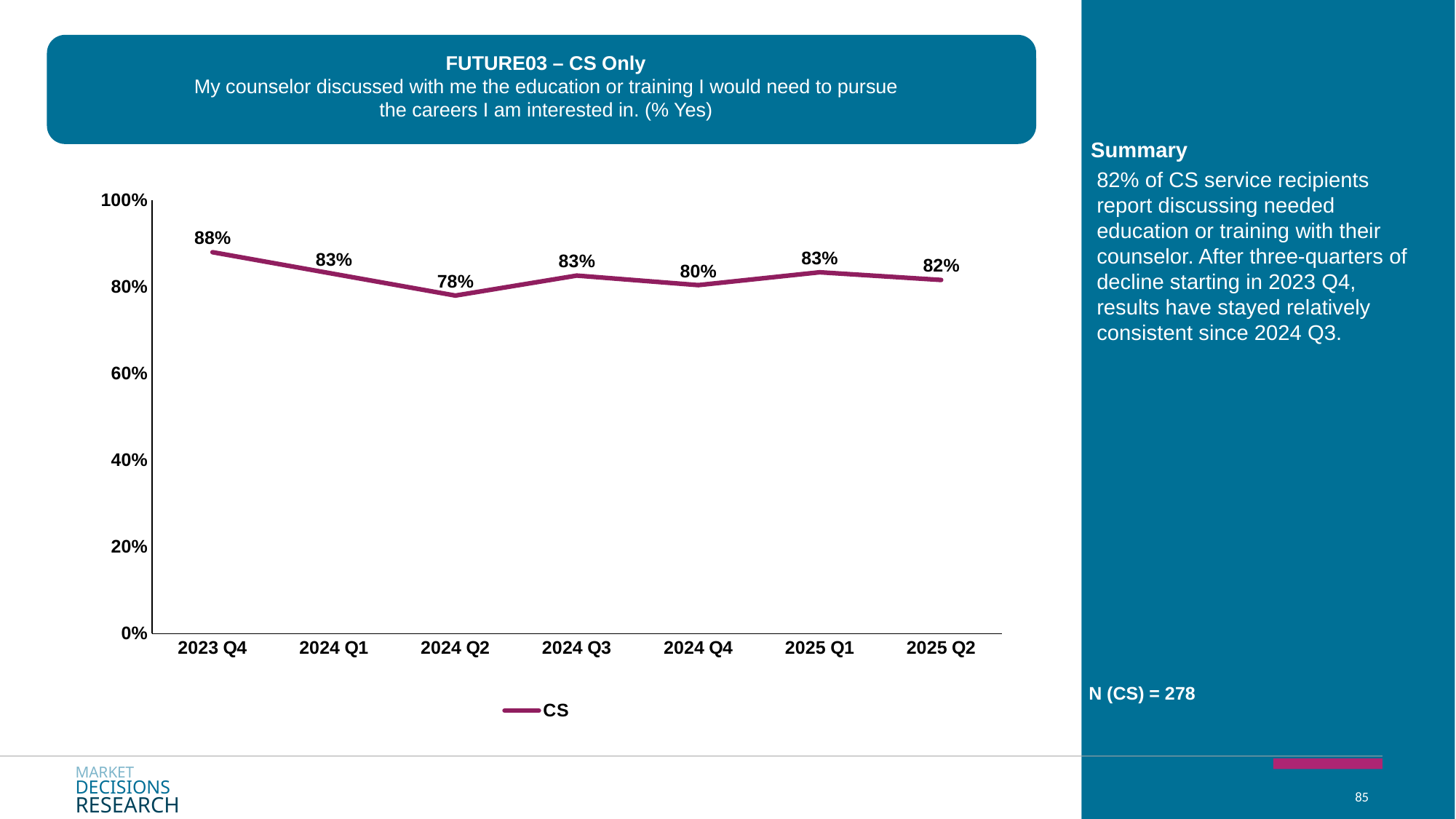
What is the value for 2024 Q2? 78% What is the value for 2023 Q4? 88% What is the value for 2024 Q4? 80% Which is larger, the value for 2024 Q4 or the value for 2025 Q1? 2025 Q1 What is the difference between the values for 2023 Q4 and 2024 Q2? 10% Which quarter has the highest value? 2023 Q4 What kind of chart is shown on the slide? Line chart What is the value for 2025 Q2? 82% Does the value rise or fall from 2023 Q4 to 2024 Q2? Fall How many quarters are plotted on the x axis? 7 Which quarter has the lowest value? 2024 Q2 How many series does the legend list? 1